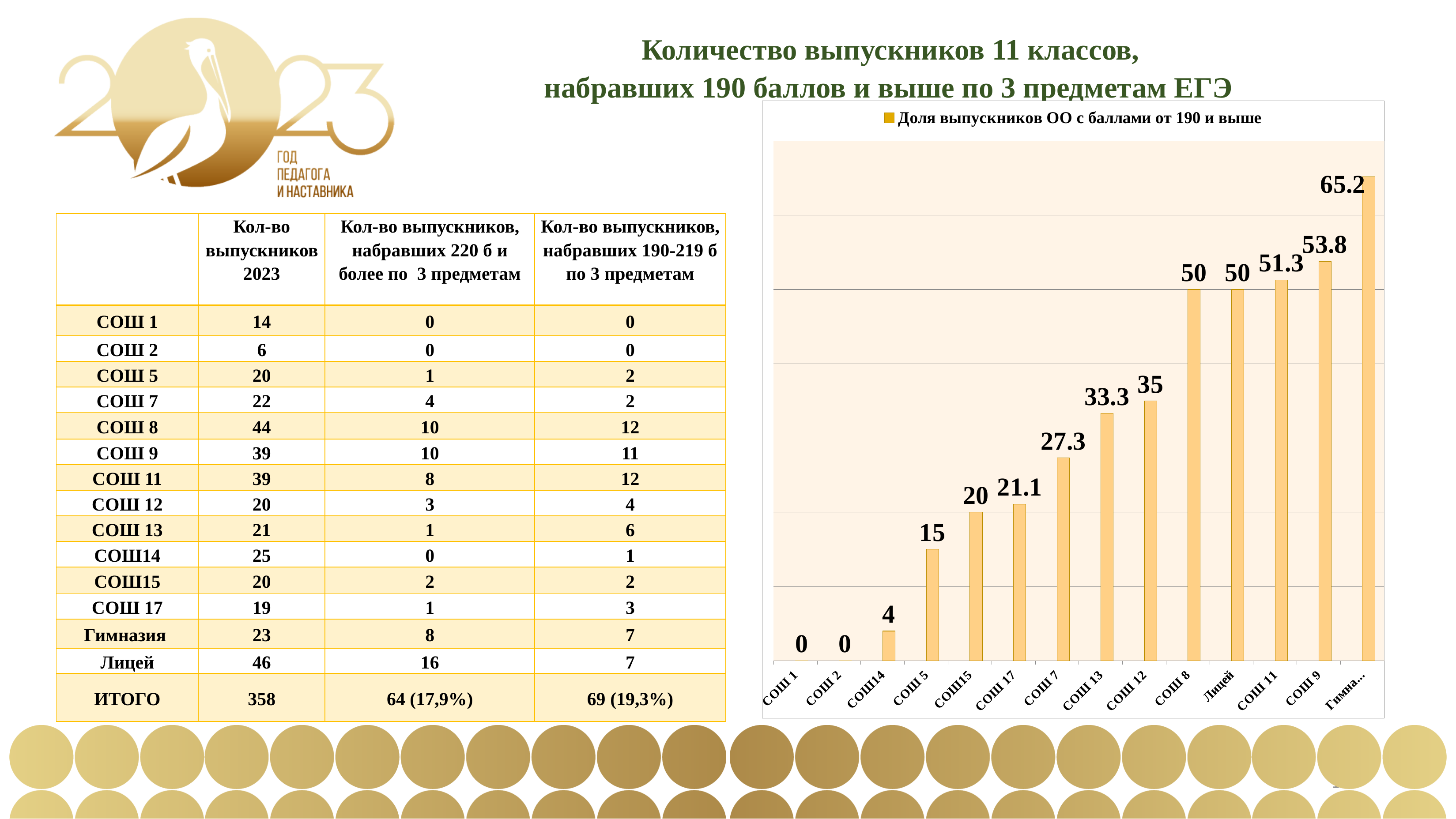
Which category has the lowest value among СОШ14, СОШ 5 and СОШ15? СОШ14 What is the value for Лицей in the chart? 50 Do the bar values rise or fall from left to right along the x axis? rise What type of chart is shown on the slide? bar chart What is the value of the rightmost bar in the chart? 65.2 How many series does the chart legend list? 1 What is the difference between the values for СОШ 11 and СОШ 12? 16.3 How many categories are plotted in the chart? 14 What is the value for СОШ 13 in the chart? 33.3 Which is larger, the value for СОШ 17 or the value for СОШ15? СОШ 17 What is the value for СОШ 7 in the chart? 27.3 What is the value for СОШ 9 in the chart? 53.8